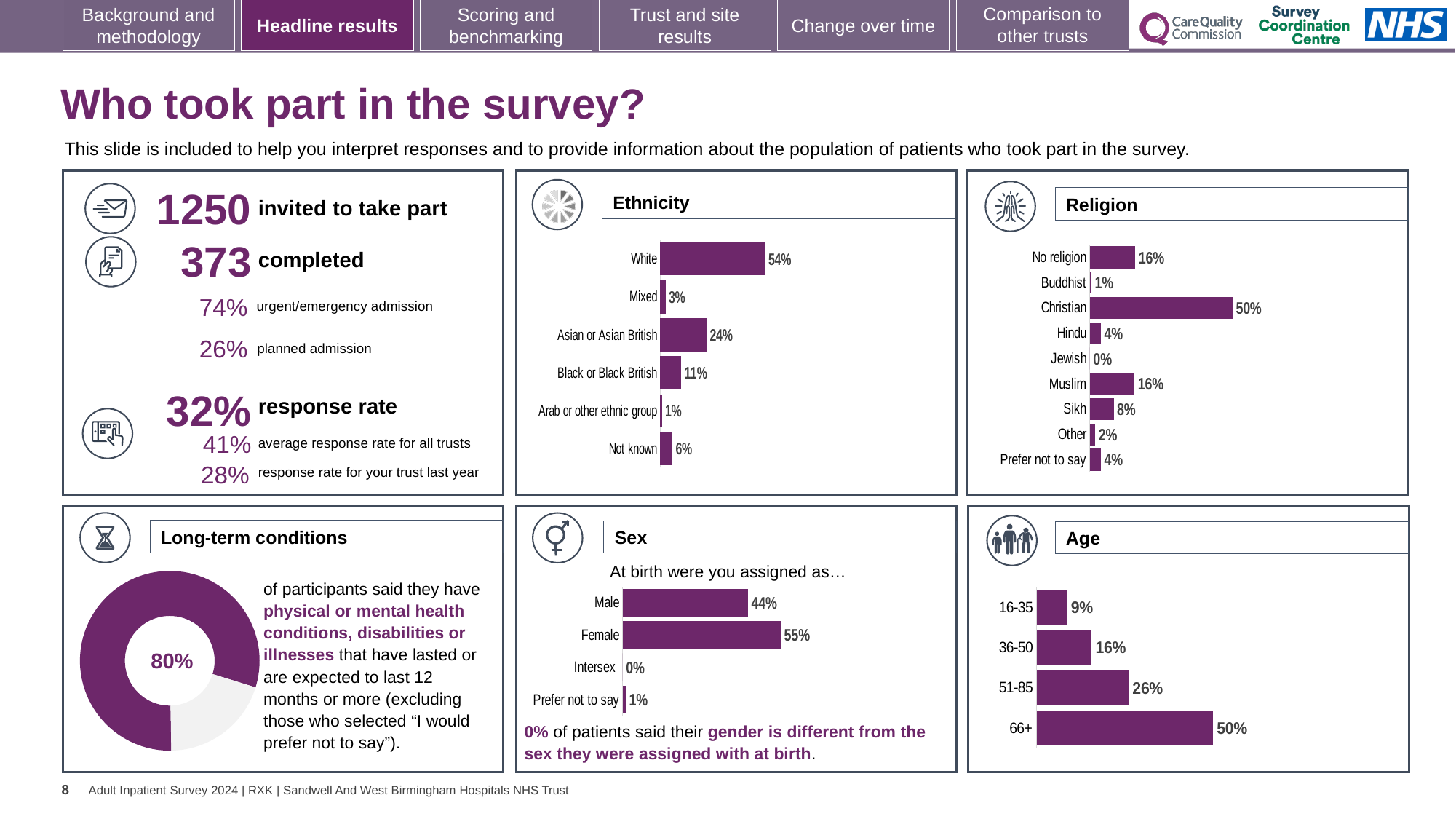
In the Sex chart, which is larger, Male or Female? Female In the Ethnicity chart, how many categories are shown? 6 In the Religion chart, what is the difference between the Christian and No religion percentages? 34% In the Religion chart, how many categories are listed? 9 What kind of chart is used in the Long-term conditions panel? doughnut chart In the Religion chart, which religion has the highest percentage? Christian In the Ethnicity chart, what percentage of respondents were White? 54% In the Age chart, what percentage of respondents were aged 66+? 50% In the Age chart, do the values rise or fall as age increases from 16-35 to 66+? rise In the Ethnicity chart, which category has the lowest value? Arab or other ethnic group In the Religion chart, what percentage of respondents were Sikh? 8% In the Sex chart, what is the difference between Female and Male? 11%